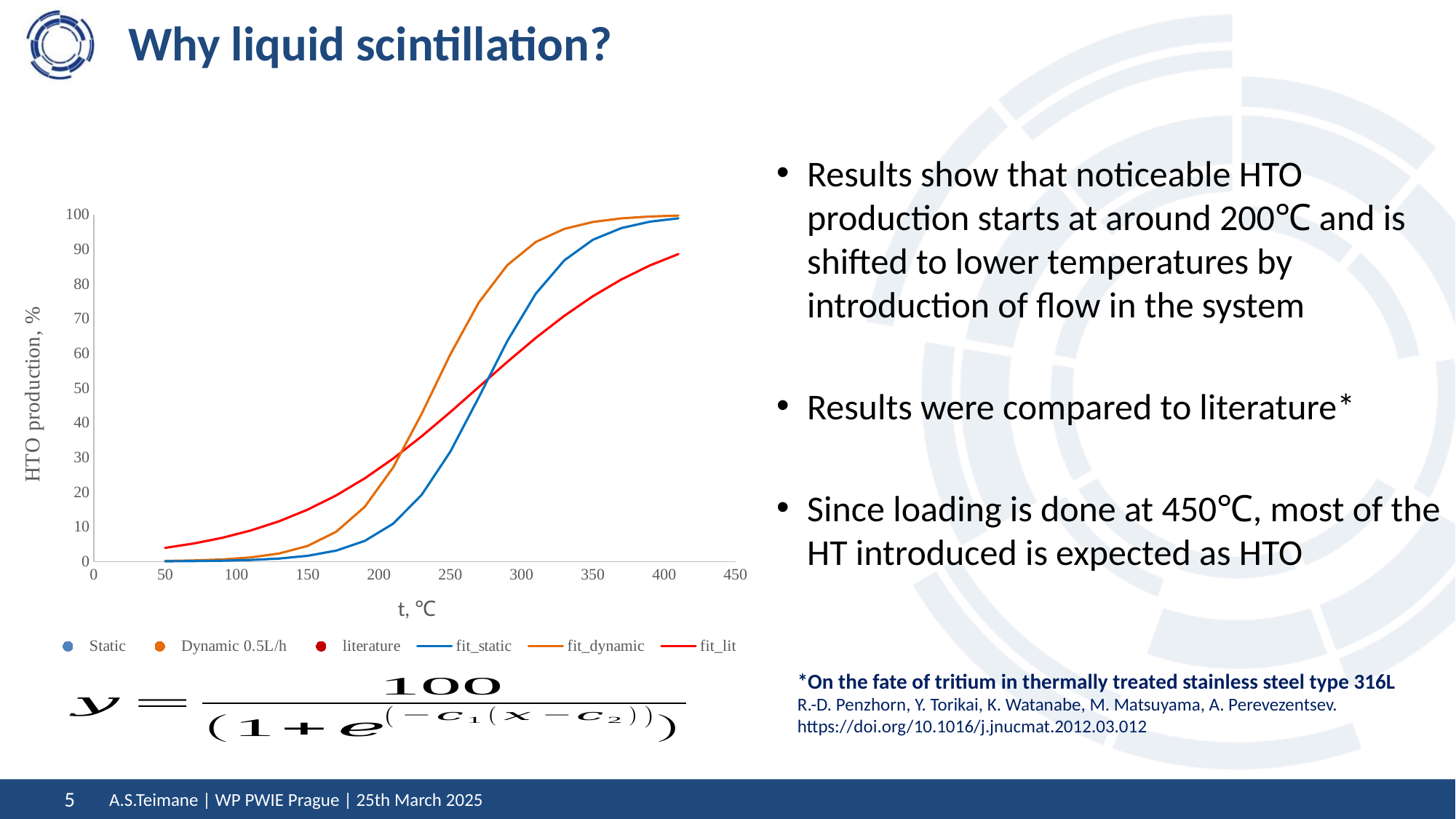
Is the value of the fit_dynamic curve at 300 °C greater or less than 80? greater Is the value of the fit_lit curve at 400 °C greater or less than 80? greater Which of the three fitted curves has the lowest value at 400 °C? fit_lit At 400 °C, which curve is higher: fit_dynamic or fit_lit? fit_dynamic How many entries does the chart legend list? 6 At 150 °C, which curve is higher: fit_lit or fit_static? fit_lit What is the y-axis title of the chart? HTO production, % What kind of chart is shown on the slide? line chart Is the value of the fit_static curve at 250 °C greater or less than 50? less What is the x-axis title of the chart? t, °C Does the fit_static curve rise or fall as temperature increases along the x axis? rise